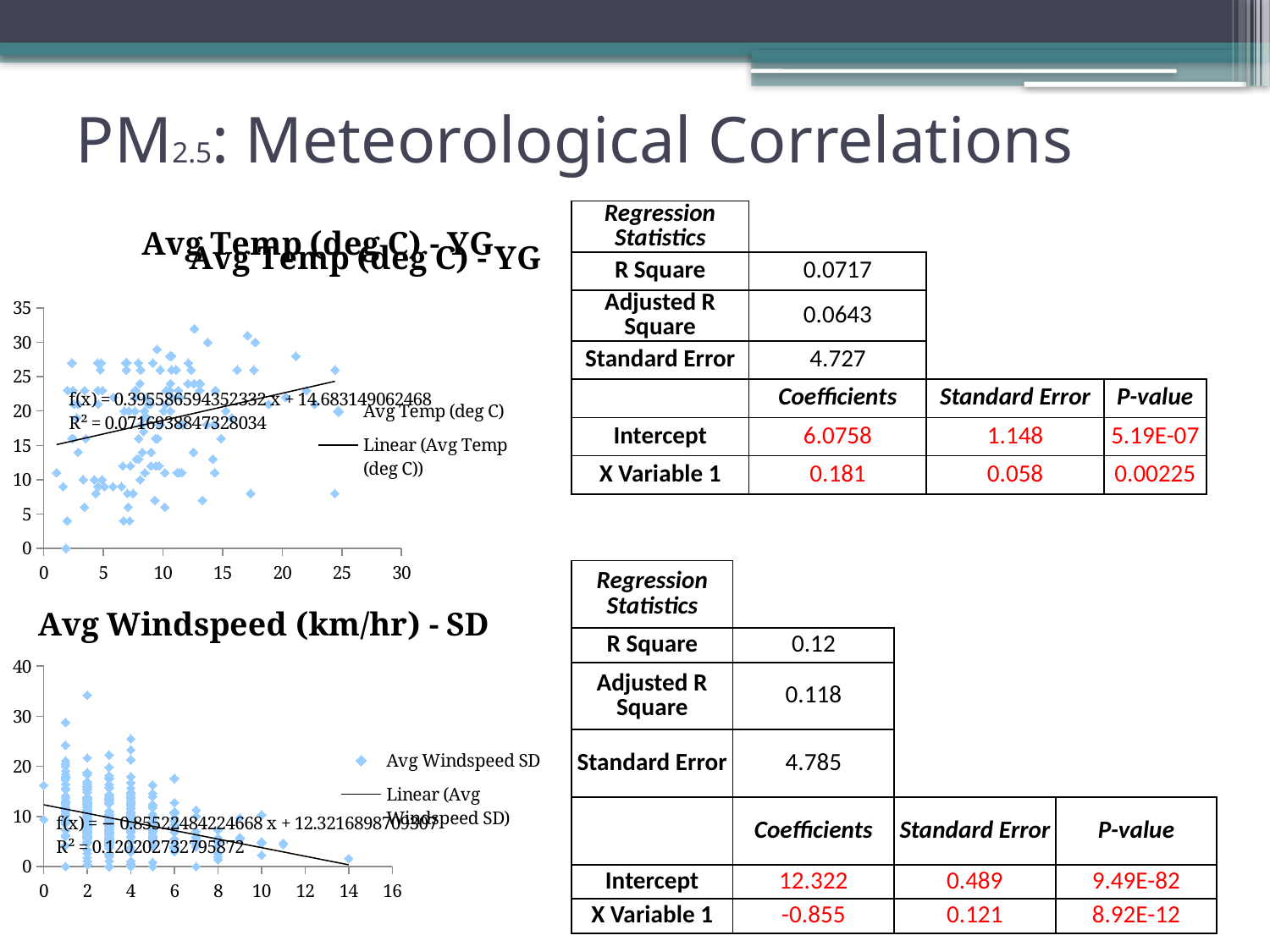
In the top chart "Avg Temp (deg C) - YG", what is the highest value shown on the y axis? 35 In the bottom chart "Avg Windspeed (km/hr) - SD", what is the highest value shown on the x axis? 16 In the bottom chart "Avg Windspeed (km/hr) - SD", does the linear trendline rise or fall as x increases? fall In the top chart "Avg Temp (deg C) - YG", does the linear trendline rise or fall as x increases? rise In the bottom chart "Avg Windspeed (km/hr) - SD", what is the name of the data series in the legend? Avg Windspeed SD In the top chart "Avg Temp (deg C) - YG", what is the R² value printed on the chart? 0.0716938847328034 What kind of chart is the bottom chart titled "Avg Windspeed (km/hr) - SD"? scatter chart In the bottom chart "Avg Windspeed (km/hr) - SD", what is the R² value printed on the chart? 0.120202732795872 What kind of chart is the top chart titled "Avg Temp (deg C) - YG"? scatter chart In the bottom chart "Avg Windspeed (km/hr) - SD", how many entries does the legend list? 2 In the top chart "Avg Temp (deg C) - YG", how many entries does the legend list? 2 In the top chart "Avg Temp (deg C) - YG", what is the slope of the trendline equation printed on the chart? 0.395586594352332